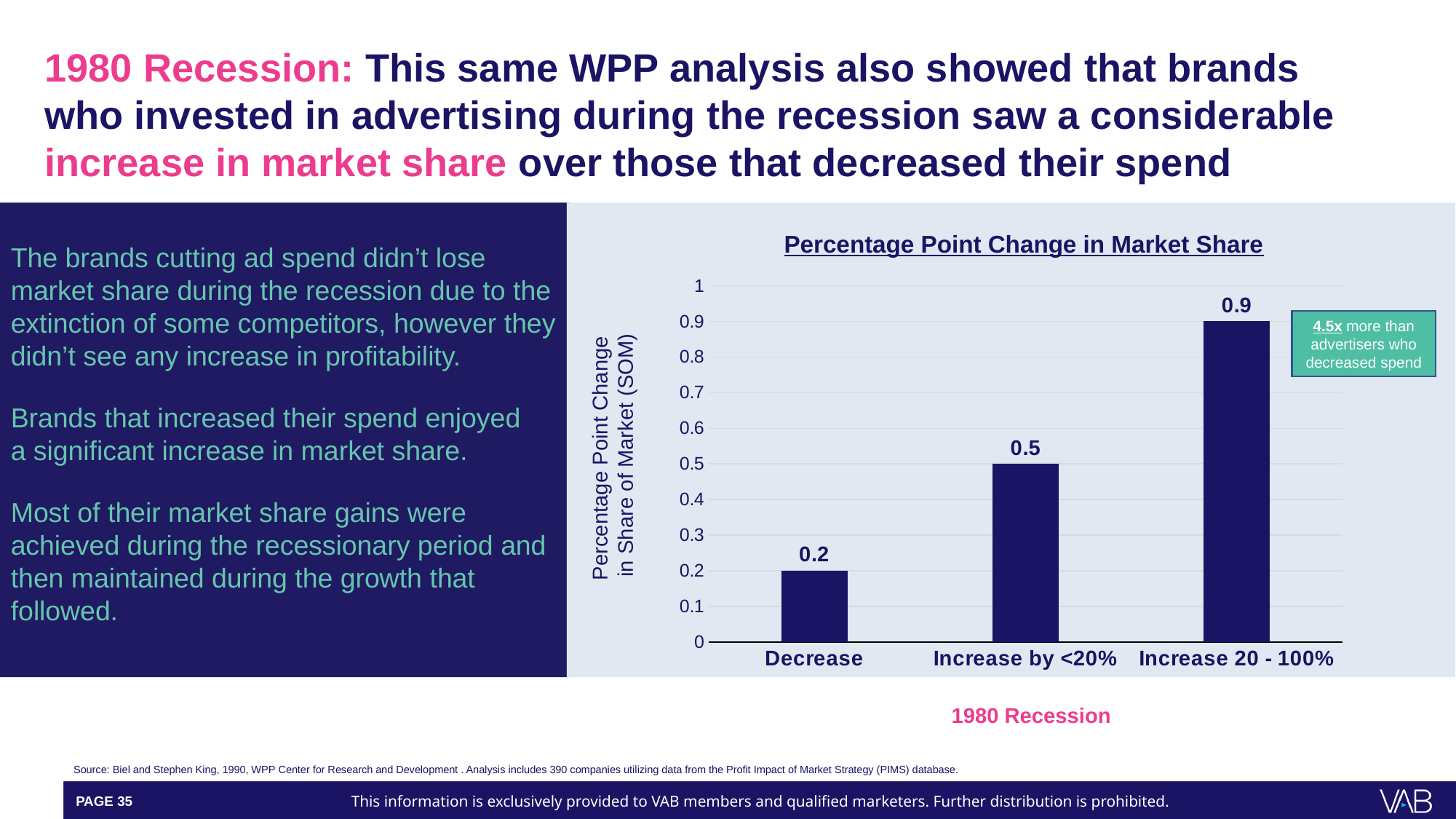
How many categories are shown on the x axis of the chart? 3 Which is larger, the value for Increase by <20% or the value for Decrease? Increase by <20% What kind of chart is shown on the slide? Bar chart Do the values rise or fall moving from left to right across the categories? Rise What is the difference between the values for Increase 20 - 100% and Decrease? 0.7 Which category has the lowest percentage point change in market share? Decrease What is the difference between the values for Increase by <20% and Decrease? 0.3 Which category has the highest percentage point change in market share? Increase 20 - 100% What is the title of the chart? Percentage Point Change in Market Share What is the percentage point change in market share for the Decrease category? 0.2 What is the percentage point change in market share for Increase by <20%? 0.5 What is the percentage point change in market share for Increase 20 - 100%? 0.9